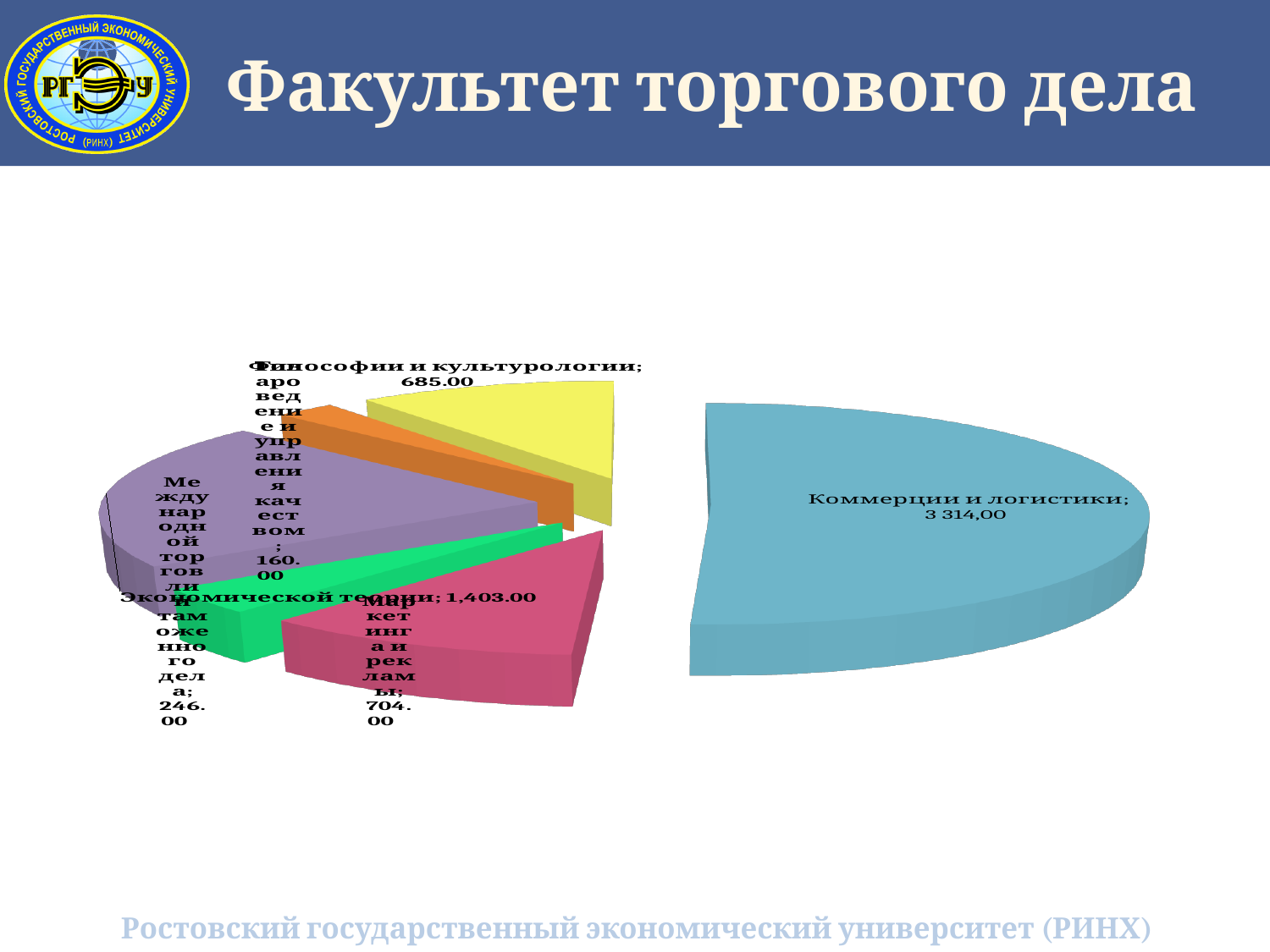
What value is shown for the Товароведения и управления качеством slice? 160.00 What is the difference between the values for Международной торговли и таможенного дела and Товароведения и управления качеством? 86.00 Which is larger, the value for Маркетинга и рекламы or the value for Философии и культурологии? Маркетинга и рекламы What value is shown for the Маркетинга и рекламы slice? 704.00 How many slices does the pie chart have? 6 What value is shown for the Философии и культурологии slice? 685.00 What kind of chart is shown on the slide? Pie chart What is the difference between the values for Коммерции и логистики and Экономической теории? 1,911.00 Which department has the smallest slice of the pie? Товароведения и управления качеством Which department has the largest slice of the pie? Коммерции и логистики What value is shown for the Экономической теории slice? 1,403.00 What value is shown for the Коммерции и логистики slice? 3 314,00